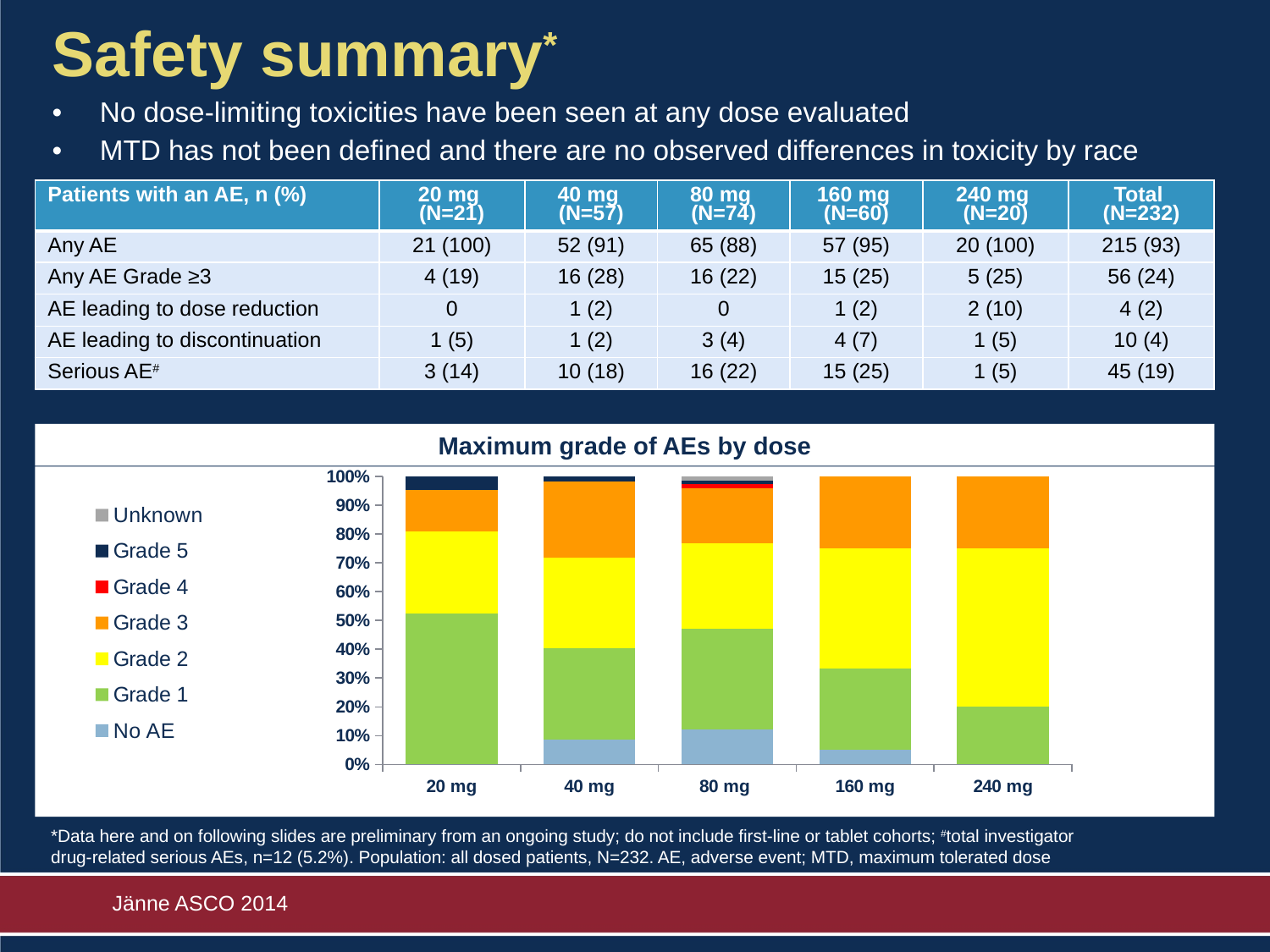
How many series does the legend of the 'Maximum grade of AEs by dose' chart list? 7 In the 'Maximum grade of AEs by dose' chart, is the top of the Grade 2 segment for 20 mg greater or less than 70%? greater In the 'Maximum grade of AEs by dose' chart, is the top of the Grade 2 segment for 40 mg greater or less than 80%? less In the 'Maximum grade of AEs by dose' chart, is the No AE segment for 80 mg greater or less than 20%? less In the 'Maximum grade of AEs by dose' chart, what total does each stacked bar reach on the y axis? 100% What is the title of the chart on the slide? Maximum grade of AEs by dose In the 'Maximum grade of AEs by dose' chart, which dose has the largest No AE segment? 80 mg How many dose categories are shown on the x axis of the 'Maximum grade of AEs by dose' chart? 5 What kind of chart is 'Maximum grade of AEs by dose'? Stacked bar chart In the 'Maximum grade of AEs by dose' chart, which dose is the only one with a visible Grade 4 segment? 80 mg In the 'Maximum grade of AEs by dose' chart, which colour represents Grade 2? Yellow In the 'Maximum grade of AEs by dose' chart, which dose has the largest Grade 1 segment? 20 mg